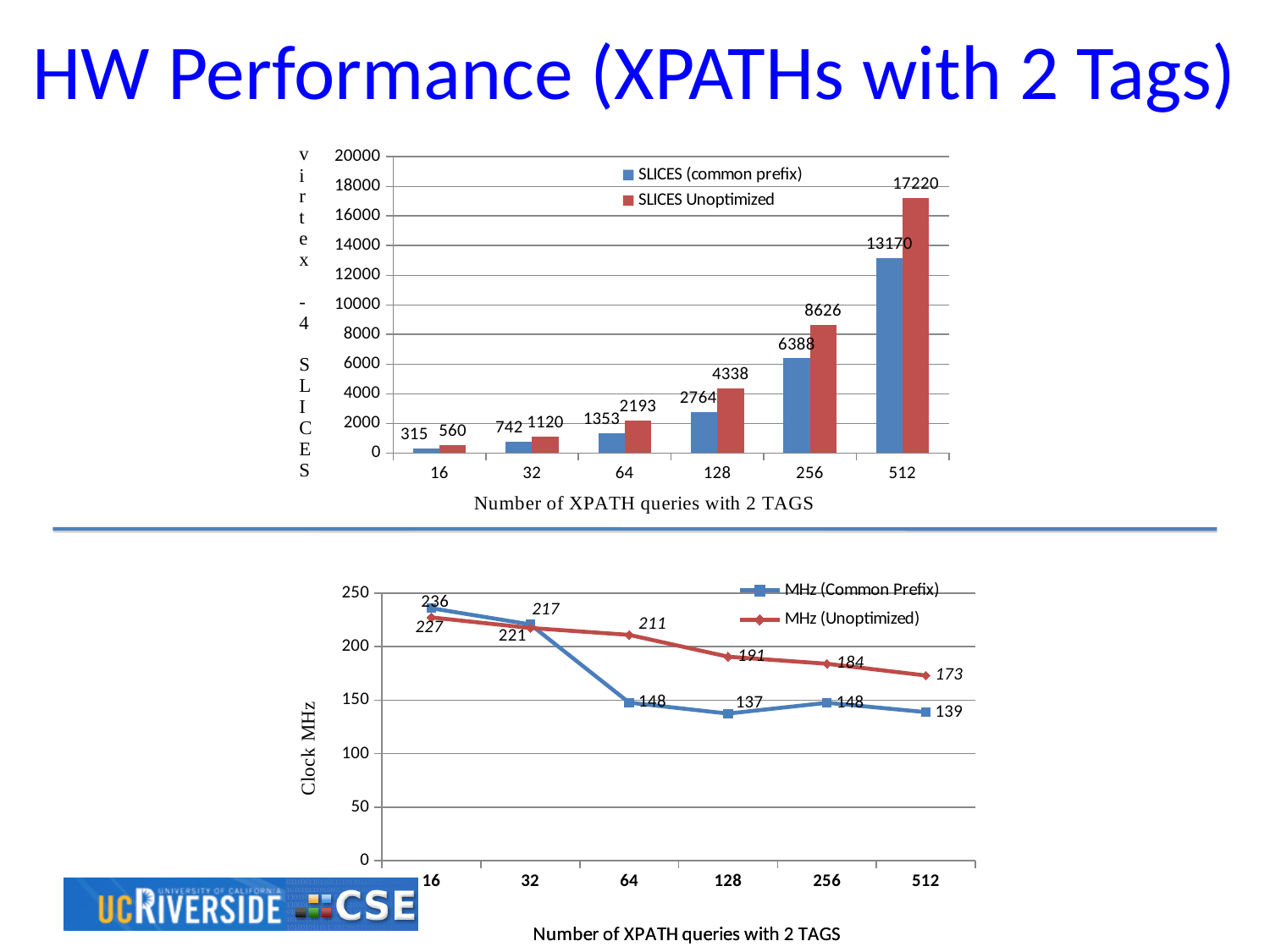
In the bottom line chart, which series has the larger value at 16 queries, MHz (Common Prefix) or MHz (Unoptimized)? MHz (Common Prefix) In the top bar chart, which number of queries has the lowest SLICES (common prefix) value? 16 In the bottom line chart, how many x-axis categories are plotted? 6 In the top bar chart, what is the SLICES Unoptimized value for 512 XPATH queries? 17220 In the bottom line chart, what is the MHz (Common Prefix) value at 128 queries? 137 What is the y-axis label of the bottom line chart? Clock MHz In the bottom line chart, what is the MHz (Unoptimized) value at 64 queries? 211 In the bottom line chart, does the MHz (Unoptimized) series rise or fall as the number of queries increases? fall In the top bar chart, what is the difference between SLICES Unoptimized and SLICES (common prefix) at 256 queries? 2238 In the top bar chart, what is the SLICES (common prefix) value for 128 XPATH queries? 2764 What kind of chart is the top chart on the slide? bar chart In the top bar chart, how many series does the legend list? 2